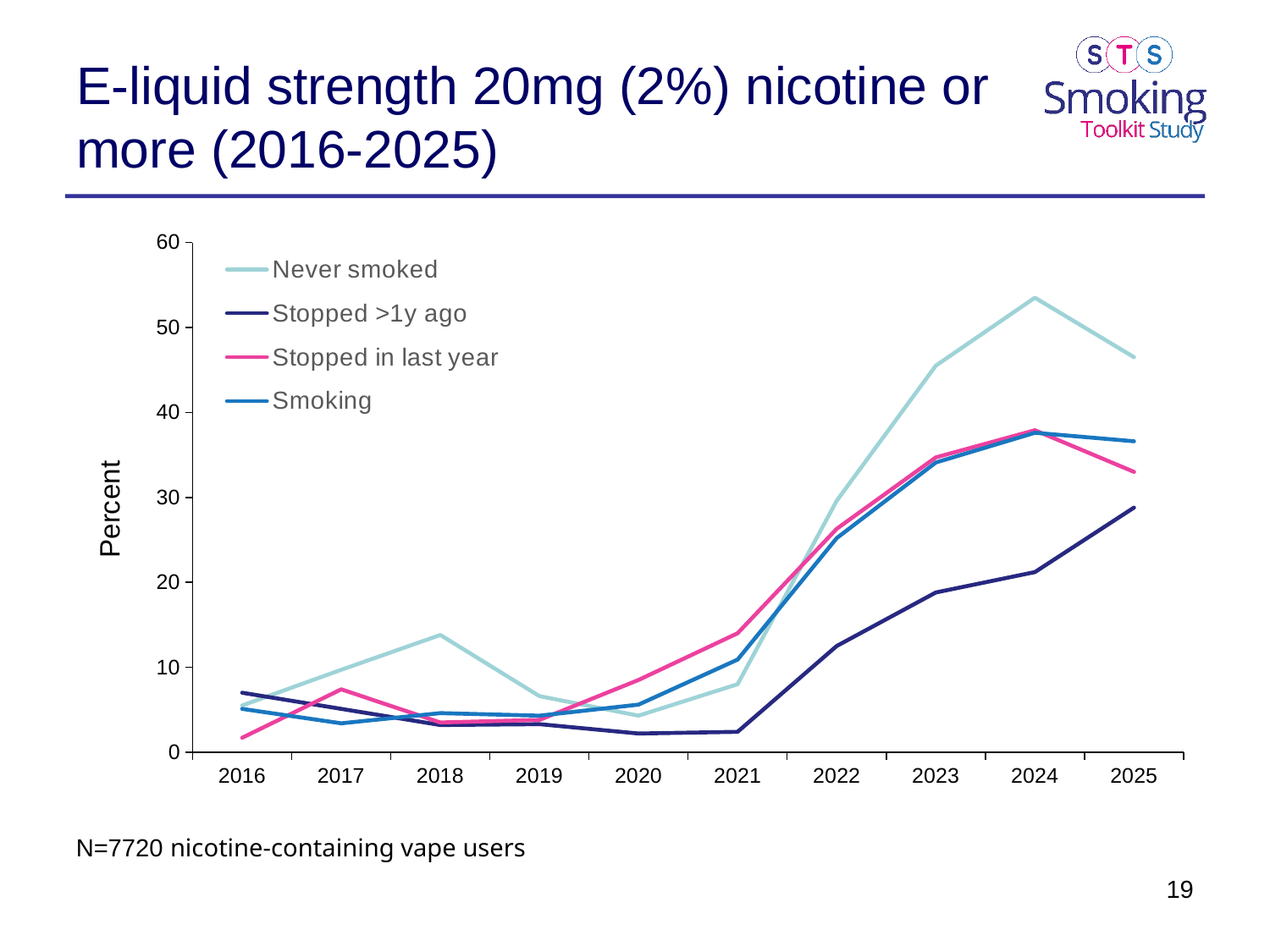
Which series has the lowest value in 2024? Stopped >1y ago Is the value for Never smoked in 2024 greater or less than 50? greater How many years are shown along the x axis? 10 In 2025, which is larger: the value for Smoking or the value for Stopped in last year? Smoking What kind of chart is shown on the slide? line chart Is the value for Stopped in last year in 2016 greater or less than 5? less Which series has the highest value in 2024? Never smoked Is the value for Stopped >1y ago in 2021 greater or less than 10? less How many series does the legend list? 4 Does the Never smoked line rise or fall between 2021 and 2024? rise Does the Never smoked line rise or fall between 2024 and 2025? fall What is the label on the y axis? Percent